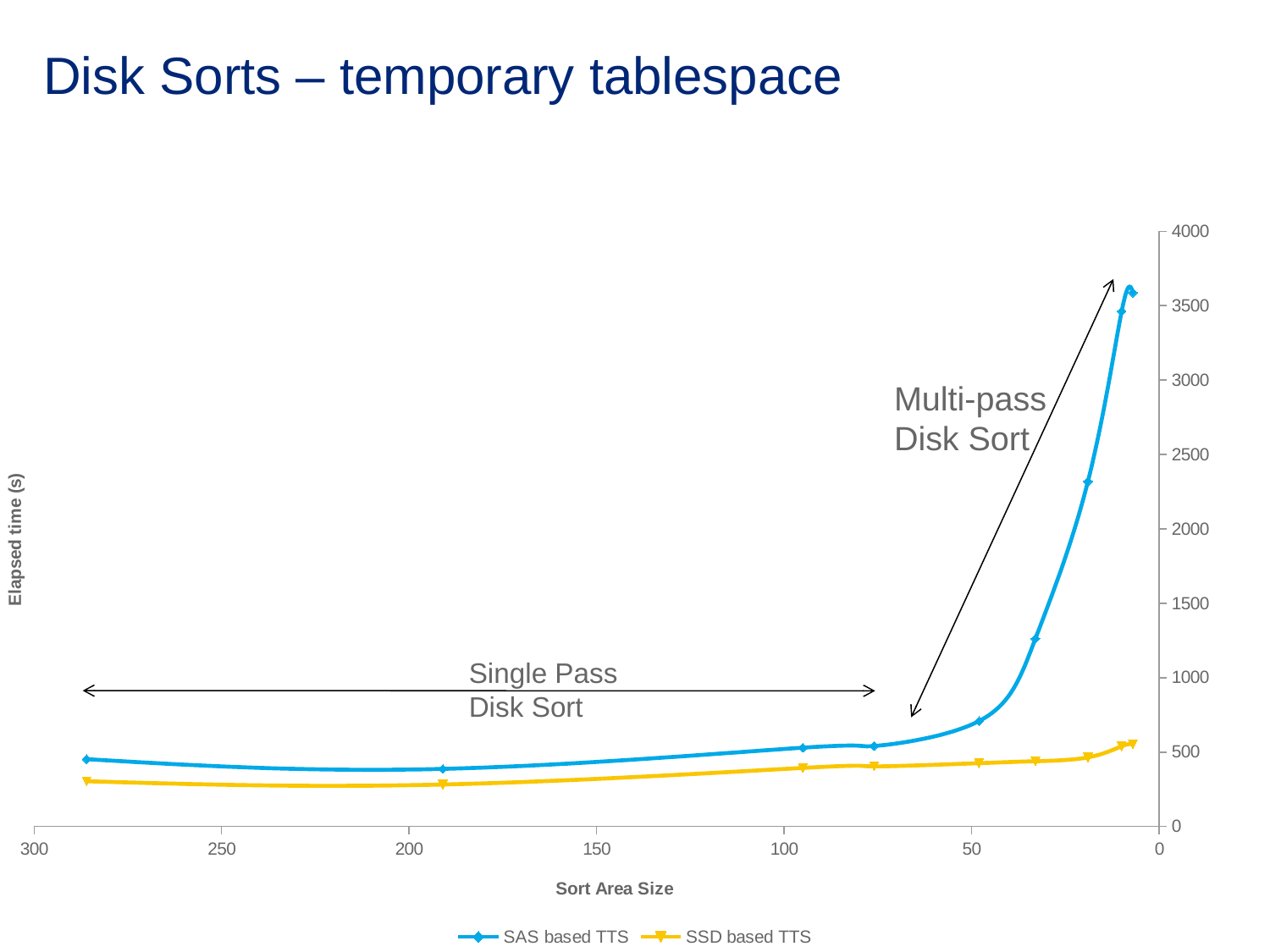
Is the value of the SSD based TTS line at the left-hand end of the chart (sort area size near 300) greater or less than 500? less Is the peak value of the SAS based TTS line greater or less than 3000? greater What kind of chart is shown on the slide? line chart Is the highest value of the SSD based TTS line greater or less than 1000? less What is the title of the y axis? Elapsed time (s) How many series does the legend list? 2 Which series has the lower elapsed time at the right-hand end of the chart (smallest sort area size)? SSD based TTS At the smallest sort area sizes on the right of the chart, which series has the larger elapsed time, SAS based TTS or SSD based TTS? SAS based TTS Which series reaches the highest elapsed time on the chart? SAS based TTS What are the two series named in the legend? SAS based TTS and SSD based TTS Moving from left to right along the x axis, does the SAS based TTS line rise or fall overall? rise